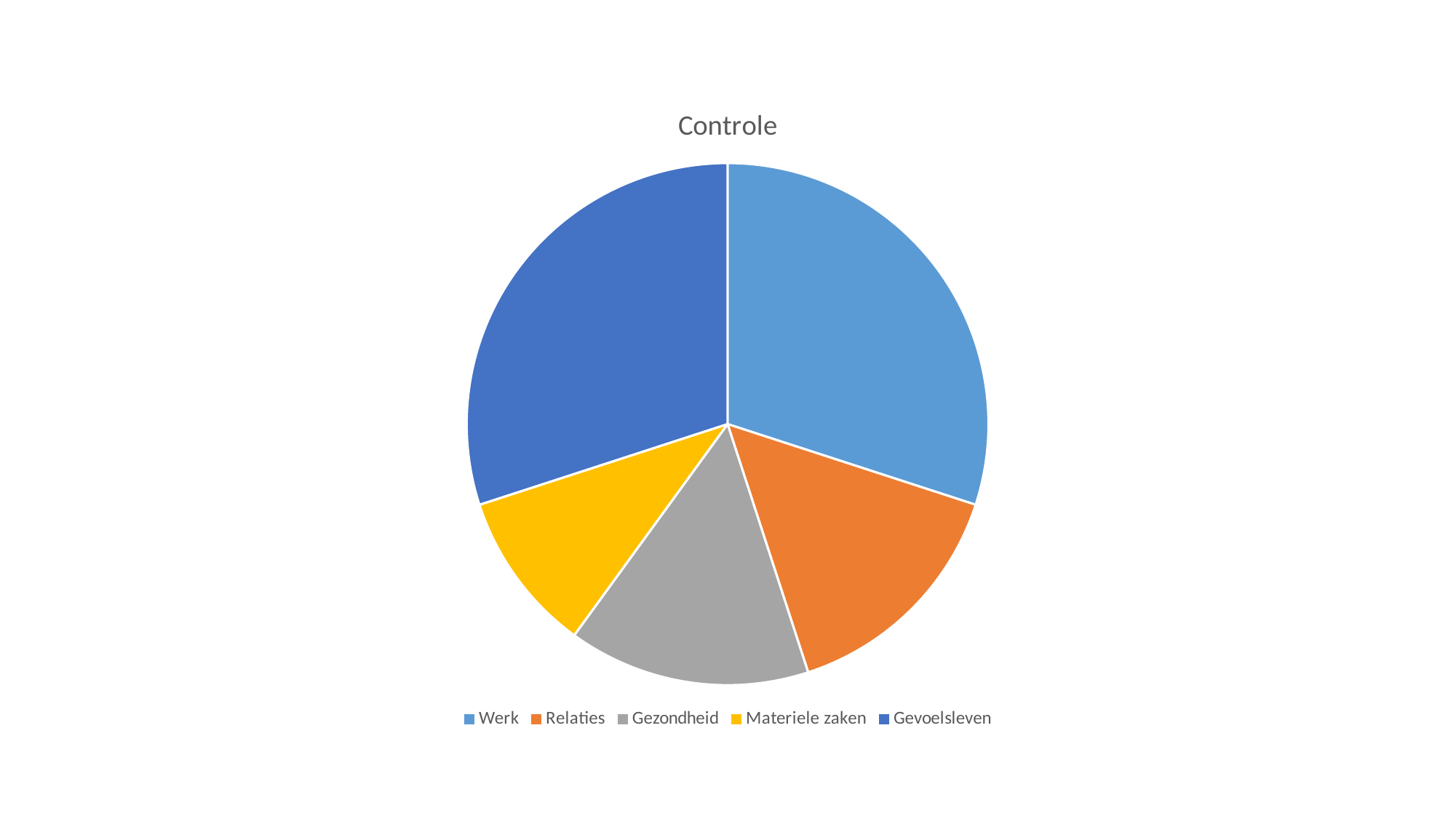
What is the title of the chart? Controle Which slice is larger, Werk or Materiele zaken? Werk Which slice is larger, Gevoelsleven or Gezondheid? Gevoelsleven How many entries does the legend list? 5 What kind of chart is shown on the slide? Pie chart Which category has the smallest slice in the pie chart? Materiele zaken Which slice is larger, Relaties or Materiele zaken? Relaties Which category is shown in yellow in the pie chart? Materiele zaken How many slices does the pie chart have? 5